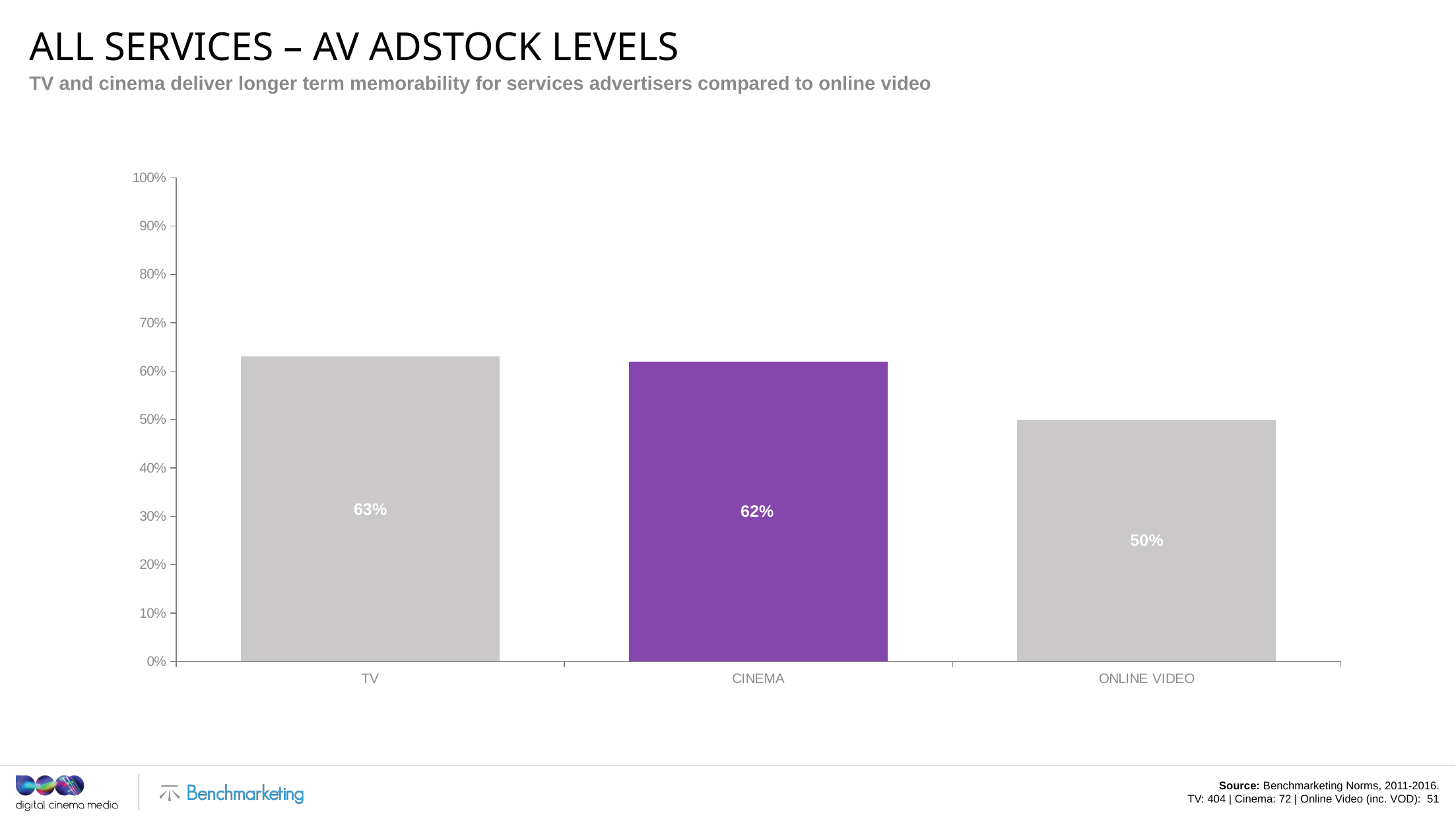
What is the AV adstock level for Cinema? 62% Which is larger, the adstock level for Cinema or for Online Video? Cinema Which bar is coloured purple rather than grey? Cinema What is the difference between the TV and Online Video adstock levels? 13% Which category has the lowest AV adstock level? Online Video What is the AV adstock level for TV? 63% Is the value for Online Video greater or less than 60%? less Is the value for TV greater or less than 60%? greater What is the difference between the Cinema and Online Video adstock levels? 12% How many categories are shown on the chart? 3 What kind of chart is shown on the slide? Bar chart What is the AV adstock level for Online Video? 50%